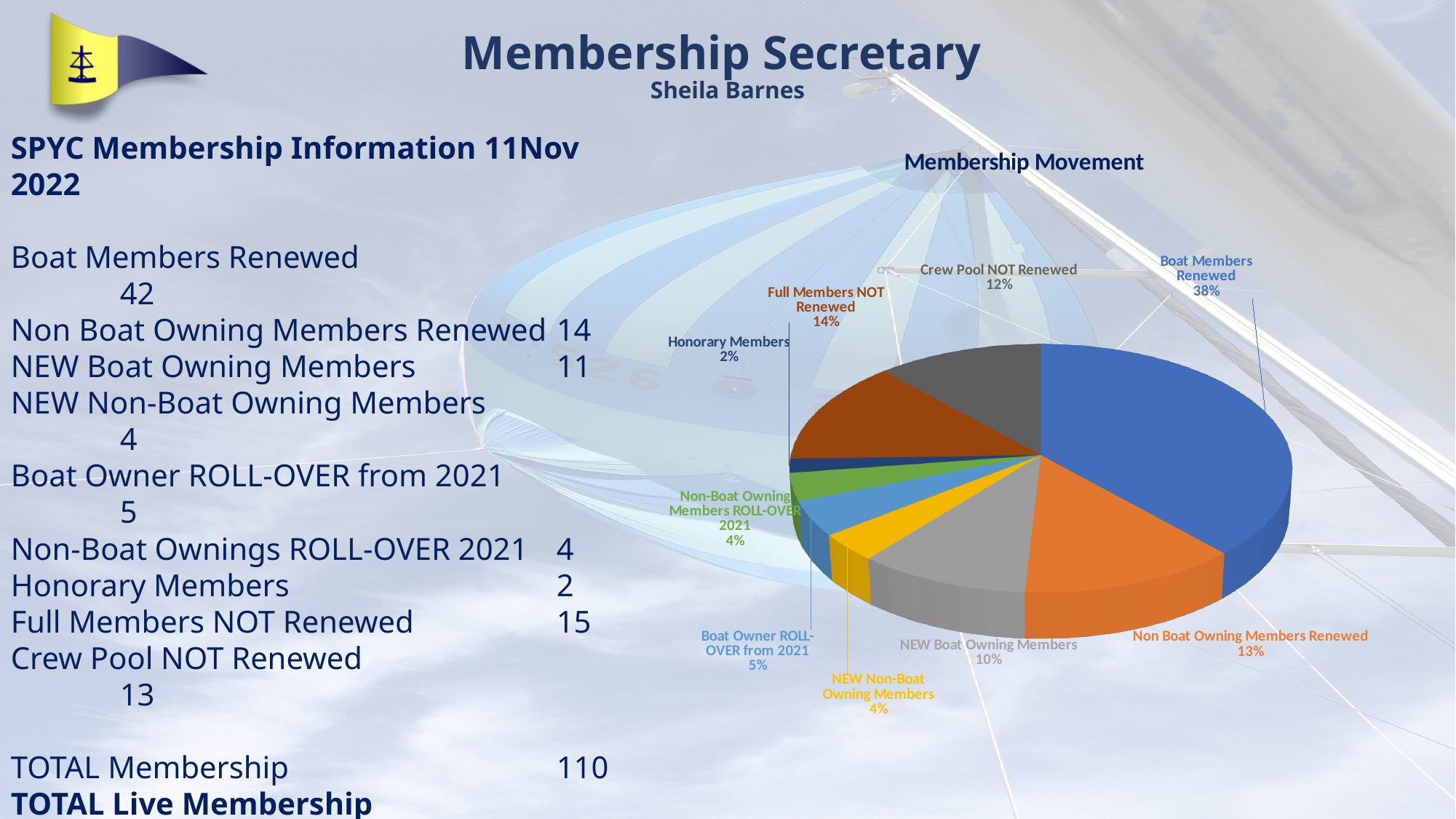
What is the difference in percentage points between Boat Members Renewed and Full Members NOT Renewed? 24 What share of the pie is Honorary Members? 2% What share of the pie is Full Members NOT Renewed? 14% What share of the pie is Crew Pool NOT Renewed? 12% How many slices does the pie chart have? 9 What is the title of the chart? Membership Movement Which is larger: the share for Non Boat Owning Members Renewed or the share for Boat Owner ROLL-OVER from 2021? Non Boat Owning Members Renewed Which slice of the pie is the largest? Boat Members Renewed What kind of chart is shown on the slide? pie chart Which slice of the pie is the smallest? Honorary Members